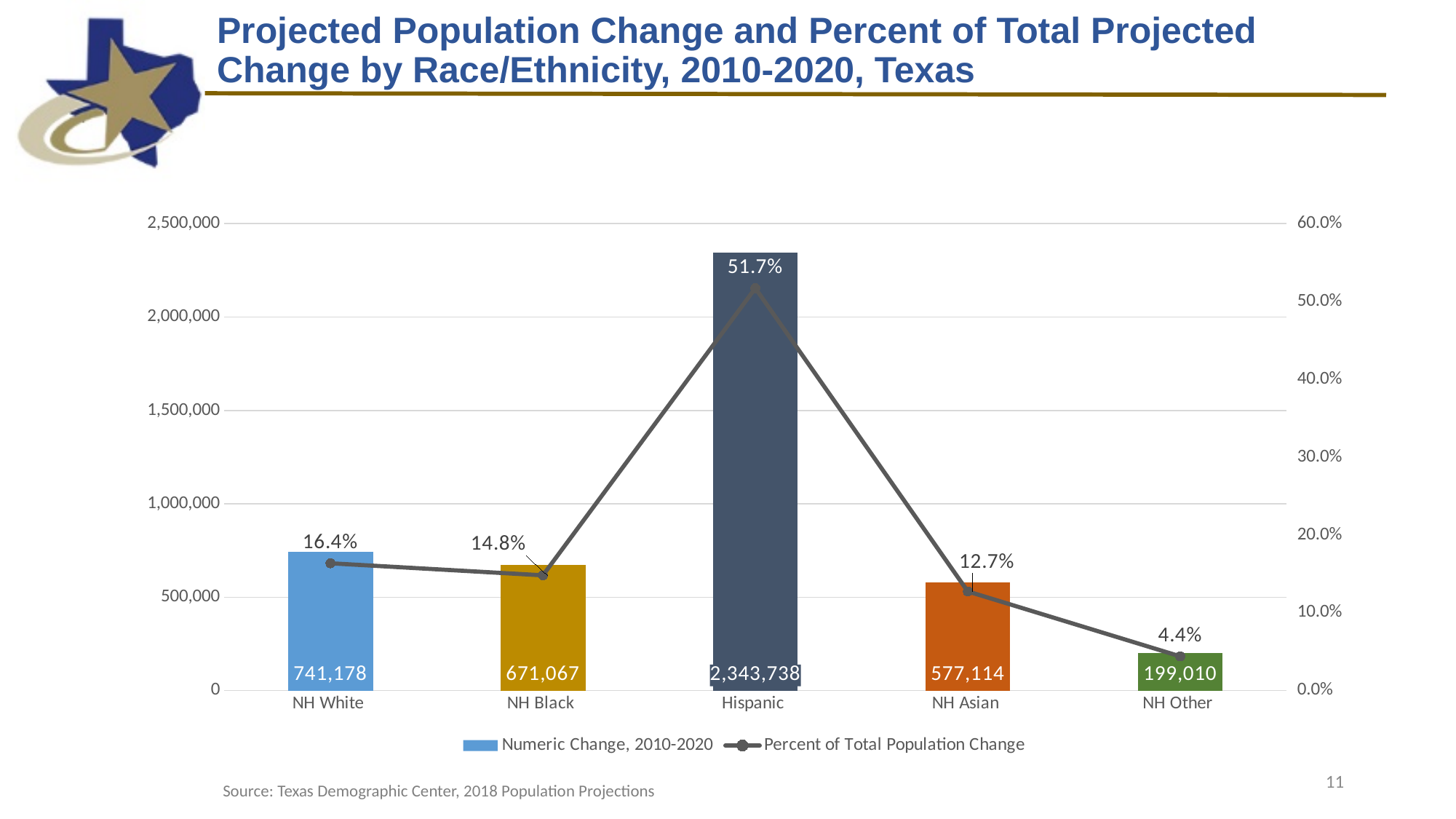
What is the Percent of Total Population Change for NH Asian? 12.7% What is the Numeric Change, 2010-2020 for NH Other? 199,010 How many series does the legend list? 2 What is the difference in Numeric Change, 2010-2020 between NH White and NH Black? 70,111 What kind of chart is used to show the Numeric Change, 2010-2020 series? Bar chart What is the Numeric Change, 2010-2020 for Hispanic? 2,343,738 How many race/ethnicity categories are shown on the x axis? 5 What is the source cited below the chart? Texas Demographic Center, 2018 Population Projections Which race/ethnicity category has the highest Numeric Change, 2010-2020? Hispanic Which has a larger Numeric Change, 2010-2020: NH Black or NH Asian? NH Black Is the Numeric Change, 2010-2020 for Hispanic greater or less than 2,000,000? greater Which race/ethnicity category has the lowest Percent of Total Population Change? NH Other